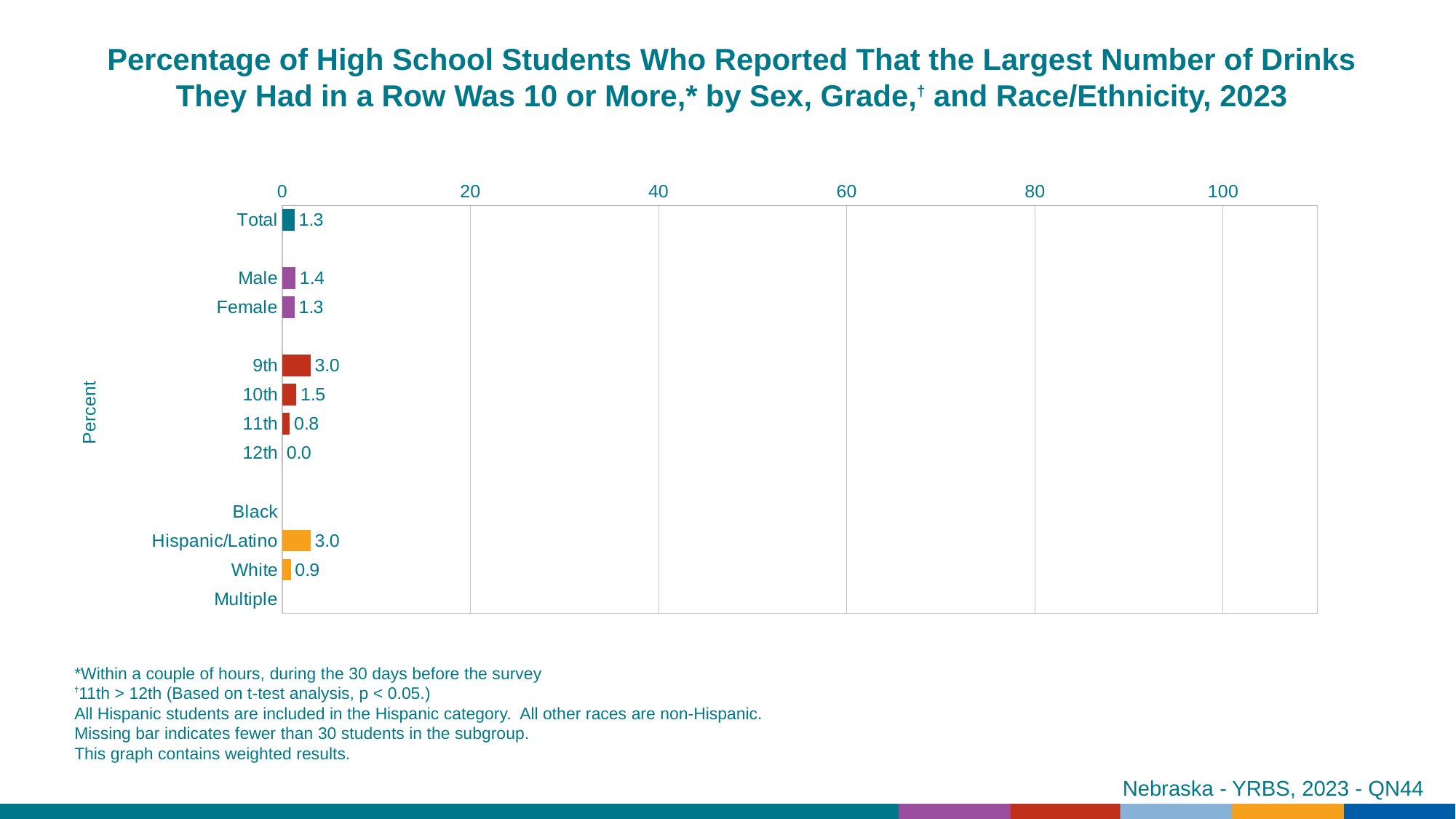
What is the value for Hispanic/Latino students? 3.0 Which grade has the lowest value? 12th What is the value for 12th grade? 0.0 Do the values rise or fall from 9th grade to 12th grade? fall How many category labels are listed on the vertical axis? 11 Is the value for Male greater or less than 20? less What is the value for Total? 1.3 What percentage is shown for 9th grade students? 3.0 What kind of chart is shown on the slide? bar chart What is the difference between the values for 9th grade and 10th grade? 1.5 Which grade has the highest value? 9th Which is larger, the value for Hispanic/Latino or the value for White? Hispanic/Latino